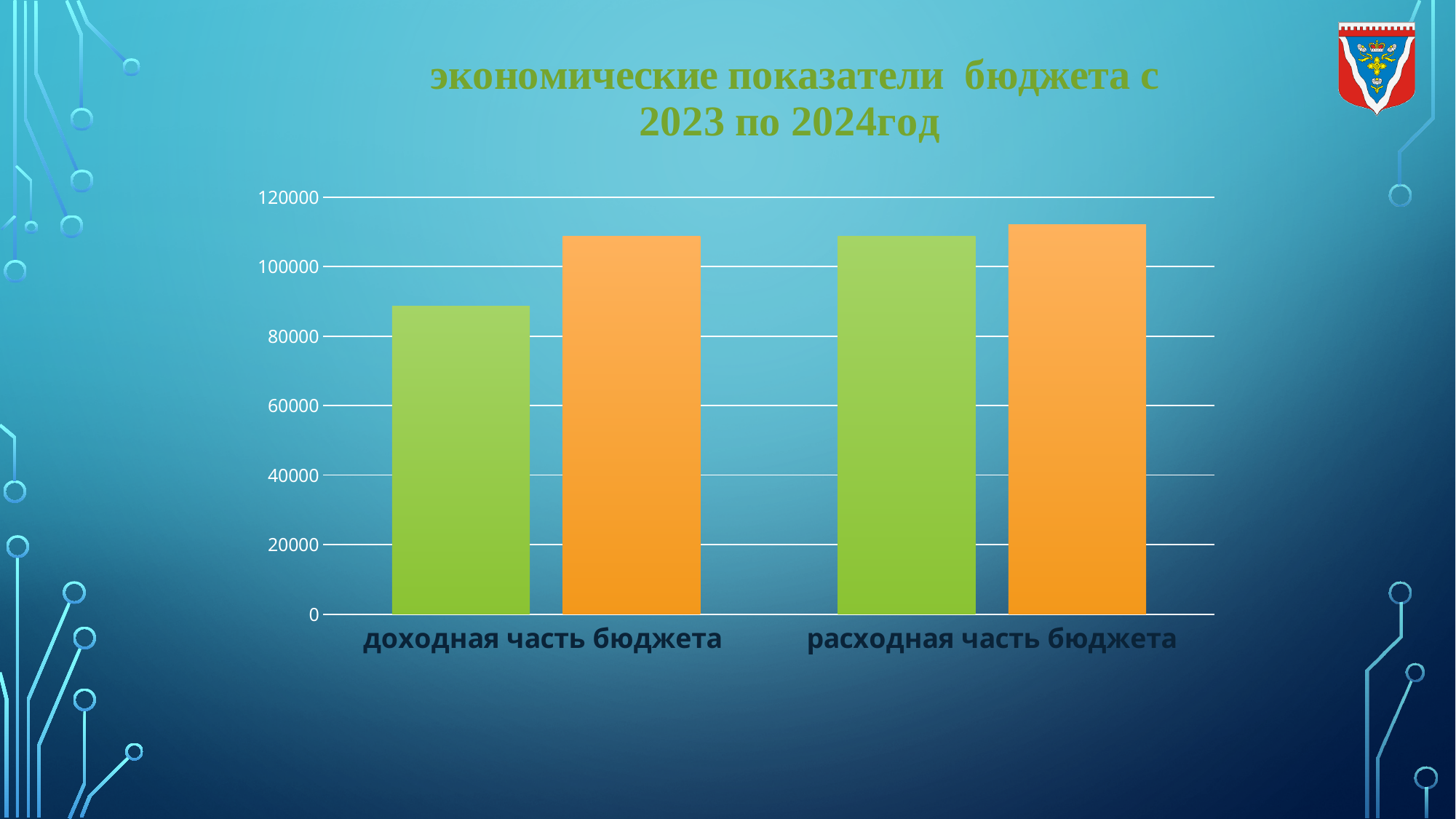
Is the value of the green bar for доходная часть бюджета greater or less than 80000? greater Is the value of the orange bar for расходная часть бюджета greater or less than 120000? less Is the value of the orange bar for доходная часть бюджета greater or less than 100000? greater Which bar in the chart is the lowest? the green bar for доходная часть бюджета Which is larger: the green bar for доходная часть бюджета or the green bar for расходная часть бюджета? the green bar for расходная часть бюджета For доходная часть бюджета, which bar is taller, the green one or the orange one? the orange one How many categories are shown on the x axis of the chart? 2 What kind of chart is shown on the slide? bar chart How many bars are plotted for each category in the chart? 2 What is the title of the slide above the chart? экономические показатели бюджета с 2023 по 2024год